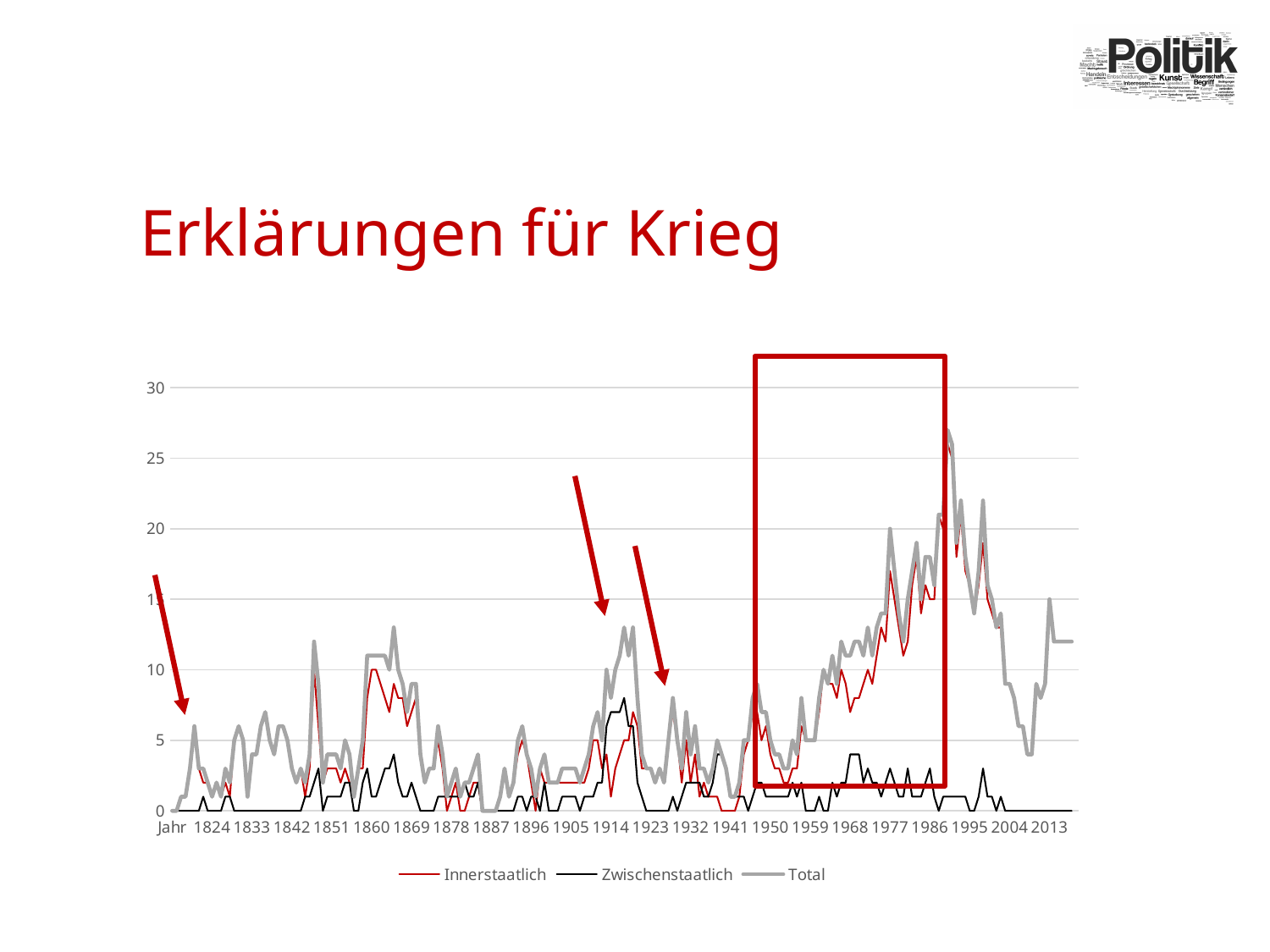
Is the value of the Total series in 2013 greater or less than 10? greater What are the three series named in the legend? Innerstaatlich, Zwischenstaatlich, Total Does the Total series generally rise or fall between 1991 and 2004? fall What kind of chart is shown on the slide? line chart Does the Total series generally rise or fall between 1950 and 1990? rise In 1986, which series has the larger value, Innerstaatlich or Zwischenstaatlich? Innerstaatlich Which series reaches the highest value on the chart? Total Is the value of the Innerstaatlich series in 1824 greater or less than 10? less Is the peak value of the Total series around 1991 greater or less than 25? greater What is the title of the slide containing the chart? Erklärungen für Krieg How many series does the legend list? 3